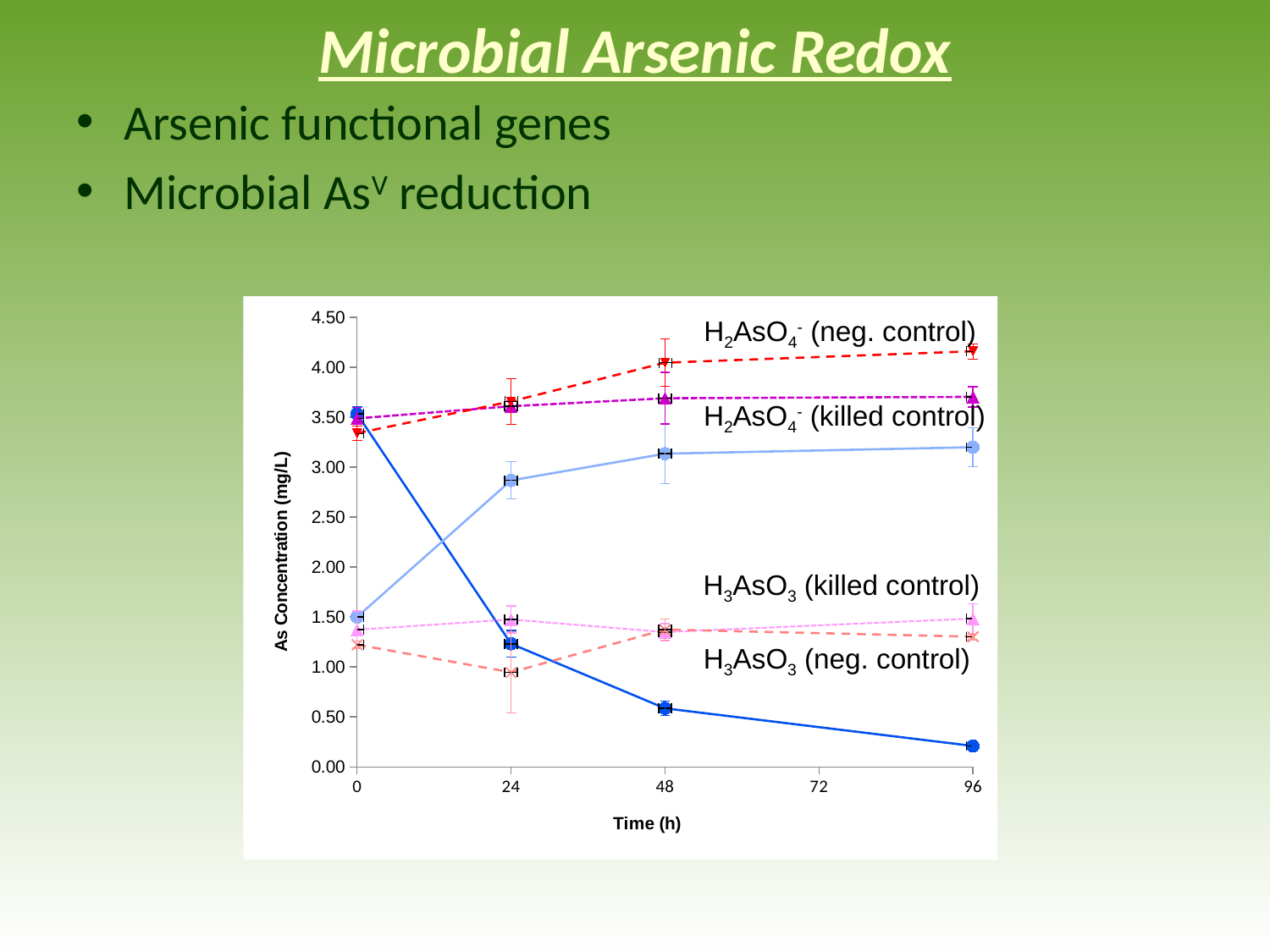
Is the value for H3AsO3 (neg. control) at 24 h greater or less than 1.50? less What is the label of the y axis of the chart? As Concentration (mg/L) Is the value for H3AsO3 (killed control) at 96 h greater or less than 2.00? less Is the value for H2AsO4- (neg. control) at 0 h greater or less than 3.50? less What is the label of the x axis of the chart? Time (h) What kind of chart is shown on the slide? line chart Which labelled series has the highest value at 96 h? H2AsO4- (neg. control) At 96 h, which is larger: H2AsO4- (neg. control) or H2AsO4- (killed control)? H2AsO4- (neg. control) How many time points are plotted for each series in the chart? 4 Does the H2AsO4- (neg. control) series rise or fall from 0 h to 96 h? rise